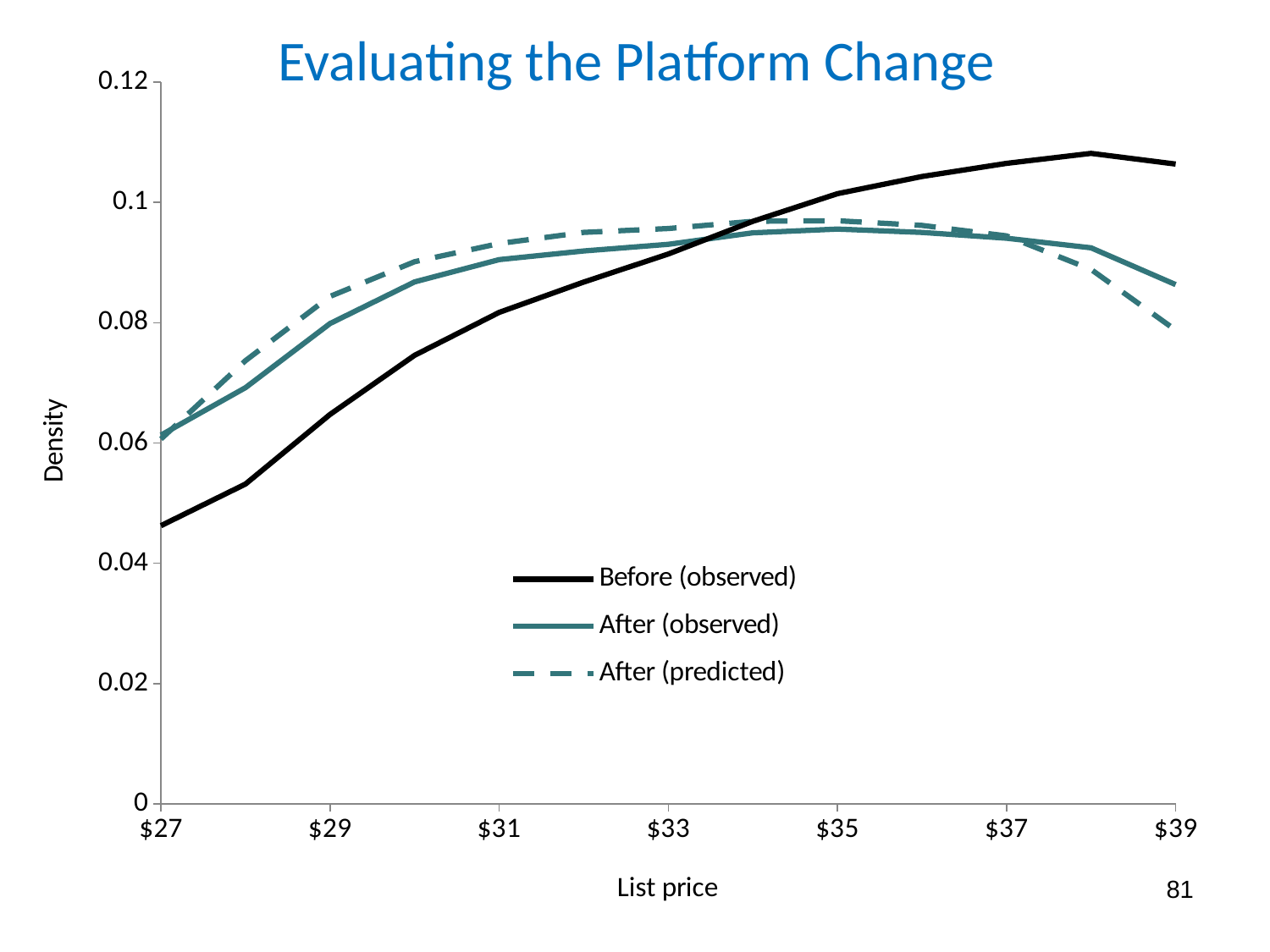
Is the value of Before (observed) at $27 greater or less than 0.06? less What kind of chart is shown on the slide? Line chart At $39, which is higher: Before (observed) or After (observed)? Before (observed) How many series does the legend list? 3 At $27, which is higher: Before (observed) or After (observed)? After (observed) At $39, which is higher: After (observed) or After (predicted)? After (observed) Is the value of After (observed) at $39 greater or less than 0.08? greater Does the Before (observed) line rise or fall from $27 to $37? rise Is the value of Before (observed) at $39 greater or less than 0.1? greater What is the title of the chart? Evaluating the Platform Change Which series is drawn with a dashed line? After (predicted)